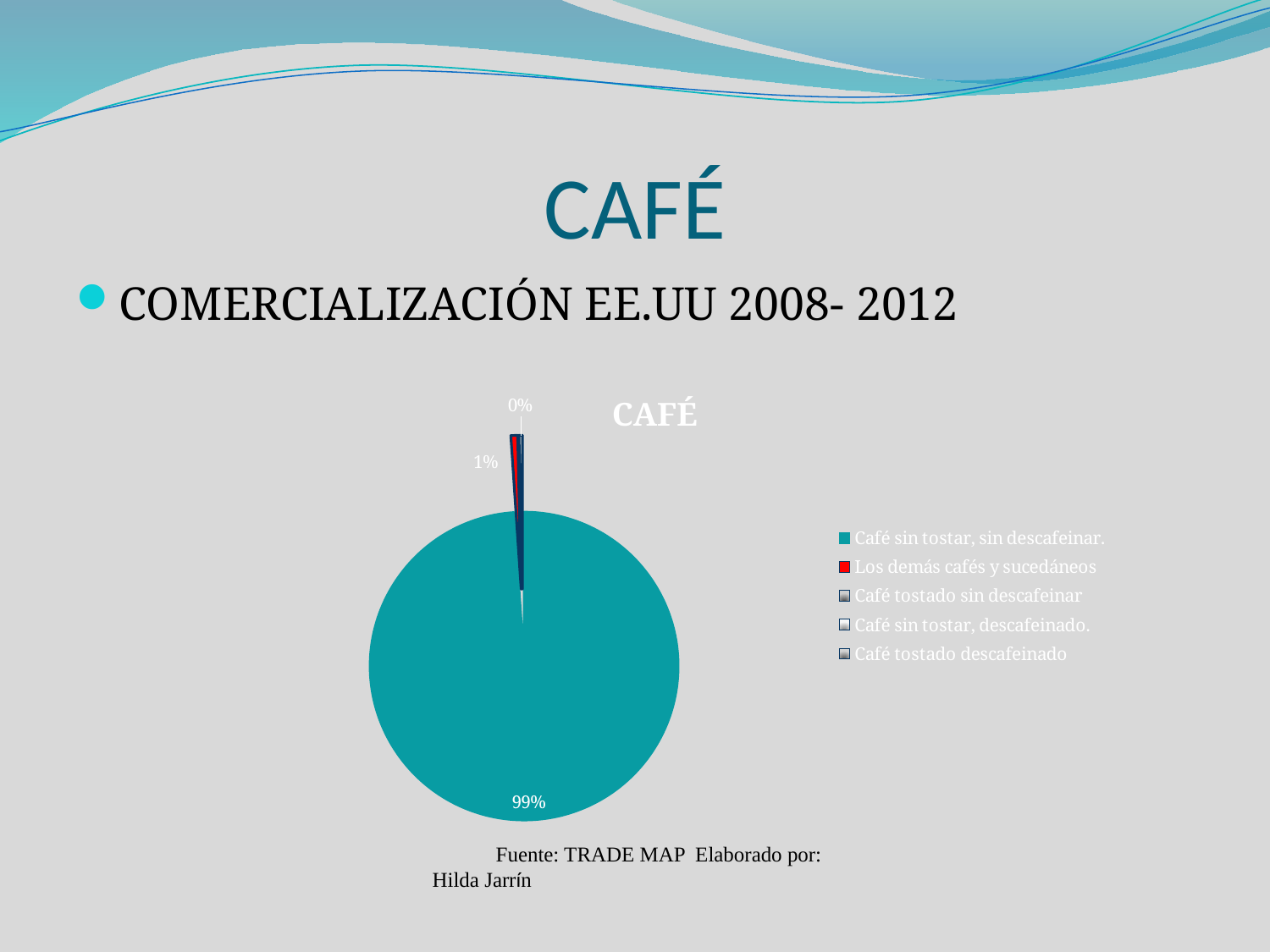
What share of the pie does 'Café sin tostar, sin descafeinar.' represent? 99% What is the title of the chart? CAFÉ What is the largest percentage label shown on the pie? 99% How many categories does the chart's legend list? 5 What is the smallest percentage label shown on the pie? 0% Which legend entry is shown in red? Los demás cafés y sucedáneos Which is larger: the share for 'Café sin tostar, sin descafeinar.' or the share for 'Los demás cafés y sucedáneos'? Café sin tostar, sin descafeinar. Is the share for 'Café sin tostar, sin descafeinar.' greater or less than 50%? greater What kind of chart is shown on the slide? pie chart Which category has the largest share of the pie? Café sin tostar, sin descafeinar.